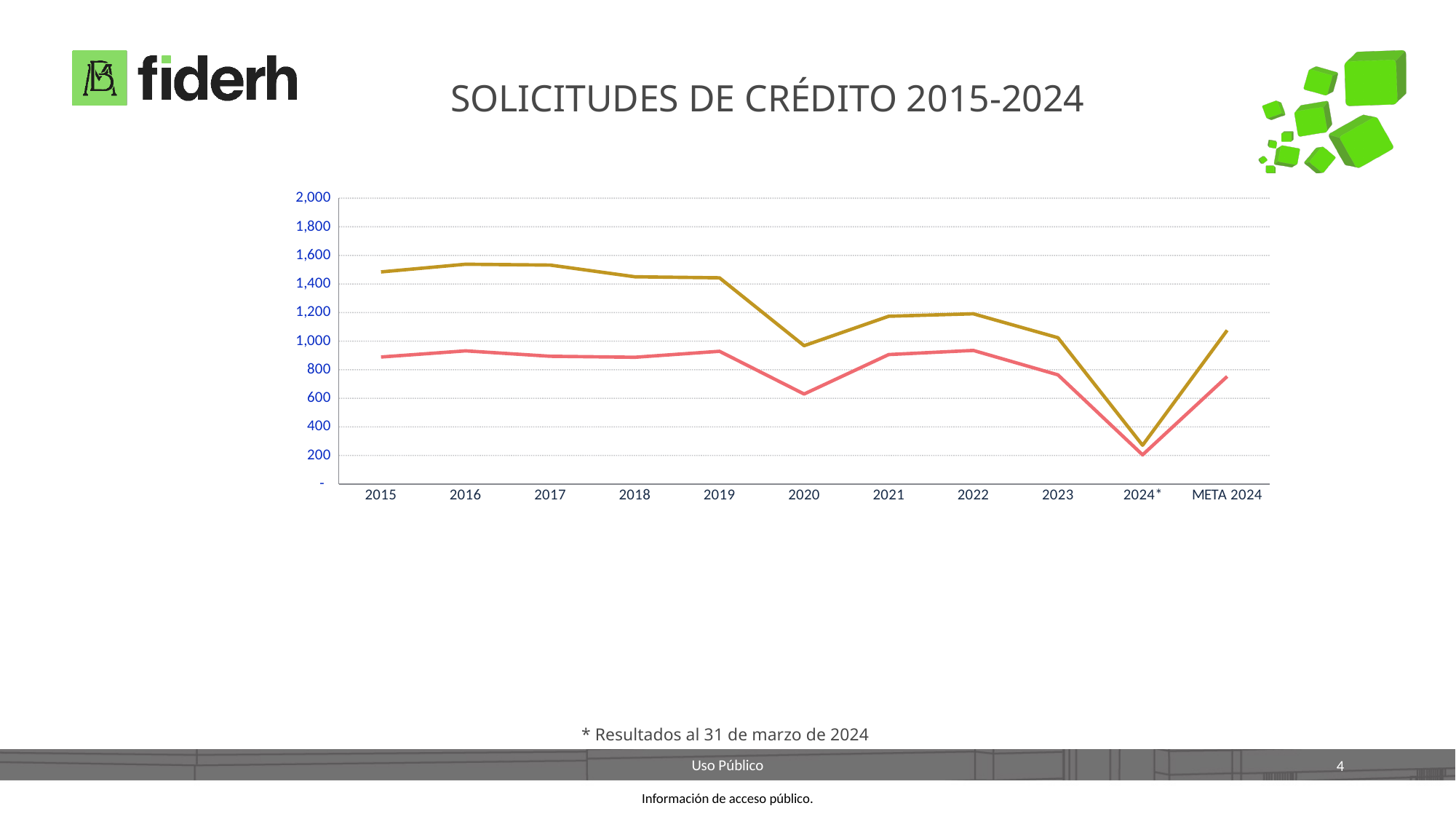
Does the gold line rise or fall from 2022 to 2024*? fall How many lines are plotted on the chart? 2 How many categories are shown along the x axis of the chart? 11 What kind of chart is shown on the slide? line chart What is the title of the chart on the slide? SOLICITUDES DE CRÉDITO 2015-2024 Is the value of the gold line for 2024* greater or less than 400? less Is the value of the pink line for 2020 greater or less than 800? less For 2019, which line has the larger value, the gold line or the pink line? the gold line In which category does the gold line reach its lowest value? 2024* Is the value of the pink line for 2015 greater or less than 800? greater In which category does the pink line reach its lowest value? 2024*